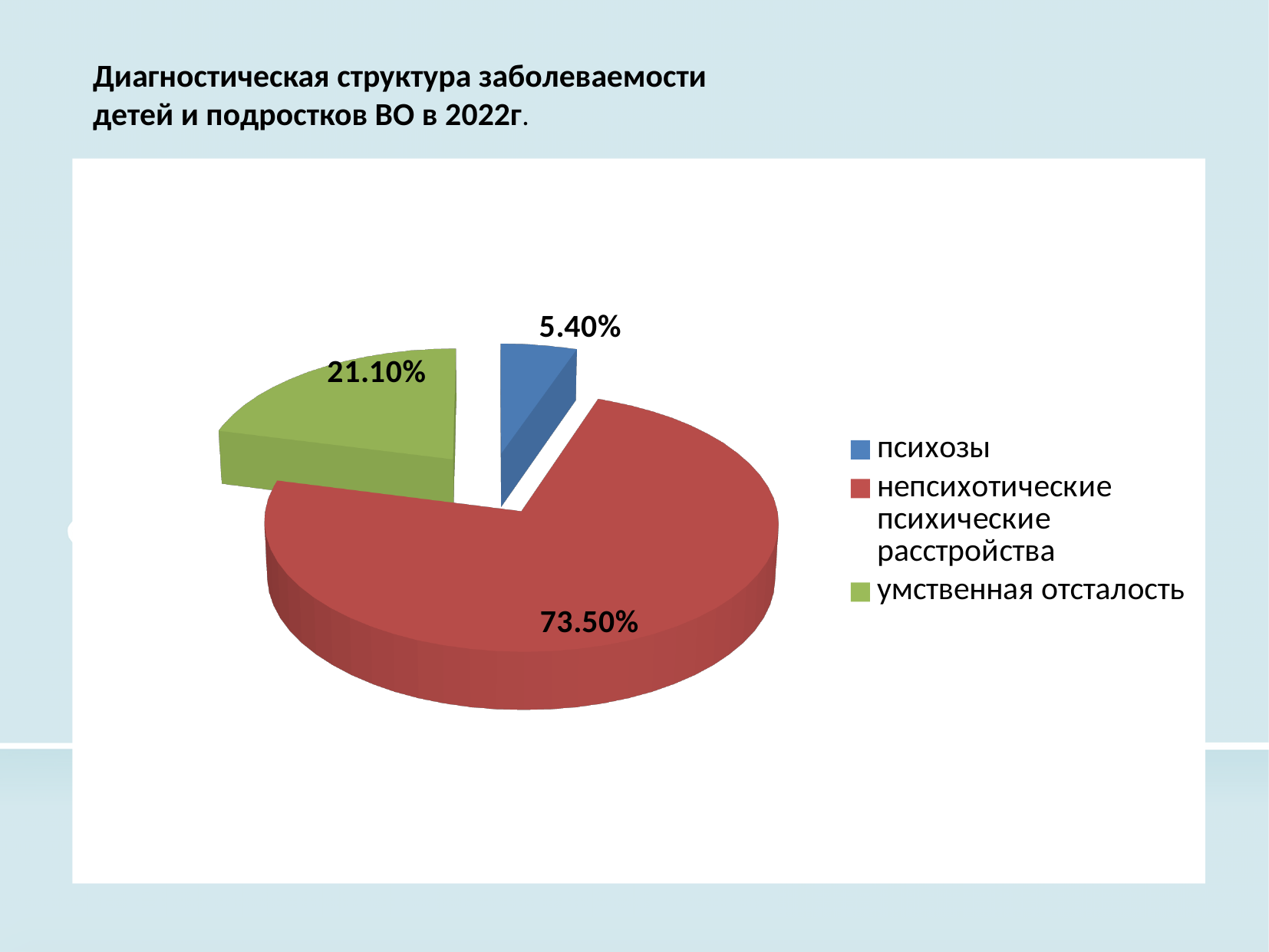
What colour is the slice for умственная отсталость? green Which category has the smallest share of the pie? психозы What is the difference between the shares of умственная отсталость and психозы? 15.70% How many slices does the pie chart have? 3 What share of the pie does психозы account for? 5.40% Which is larger: the share of умственная отсталость or the share of психозы? умственная отсталость Which category has the largest share of the pie? непсихотические психические расстройства What is the title of the slide? Диагностическая структура заболеваемости детей и подростков ВО в 2022г. What share of the pie does непсихотические психические расстройства account for? 73.50% What kind of chart is shown on the slide? pie chart What share of the pie does умственная отсталость account for? 21.10% What is the difference between the shares of непсихотические психические расстройства and умственная отсталость? 52.40%